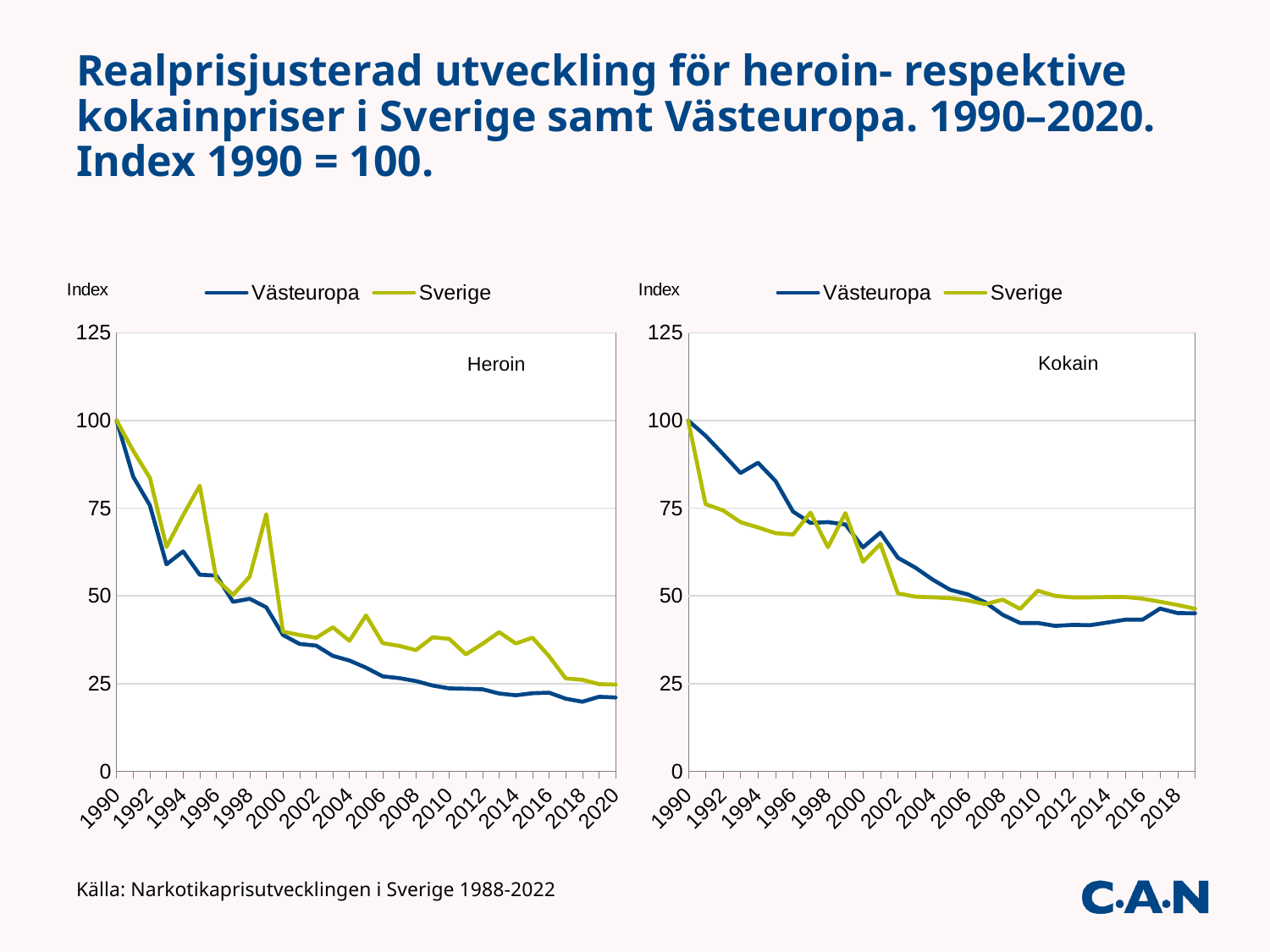
What type of chart is the Heroin chart on the left? line chart In the Heroin chart, is the value for Sverige in 1995 greater or less than 75? greater In the Heroin chart, is the value for Västeuropa in 2020 greater or less than 25? less In the Kokain chart, what is the index value for Sverige in 1990? 100 How many series does the legend of the Kokain chart list? 2 In the Heroin chart, do the Västeuropa values generally rise or fall from 1990 to 2020? fall In the Kokain chart, which series has the higher value in 1992, Västeuropa or Sverige? Västeuropa In the Heroin chart, which series has the higher value in 2005, Västeuropa or Sverige? Sverige In the Kokain chart, is the value for Västeuropa in 1994 greater or less than 75? greater In the Kokain chart, do the Sverige values generally rise or fall from 1990 to 2018? fall In the Heroin chart, what is the index value for Västeuropa in 1990? 100